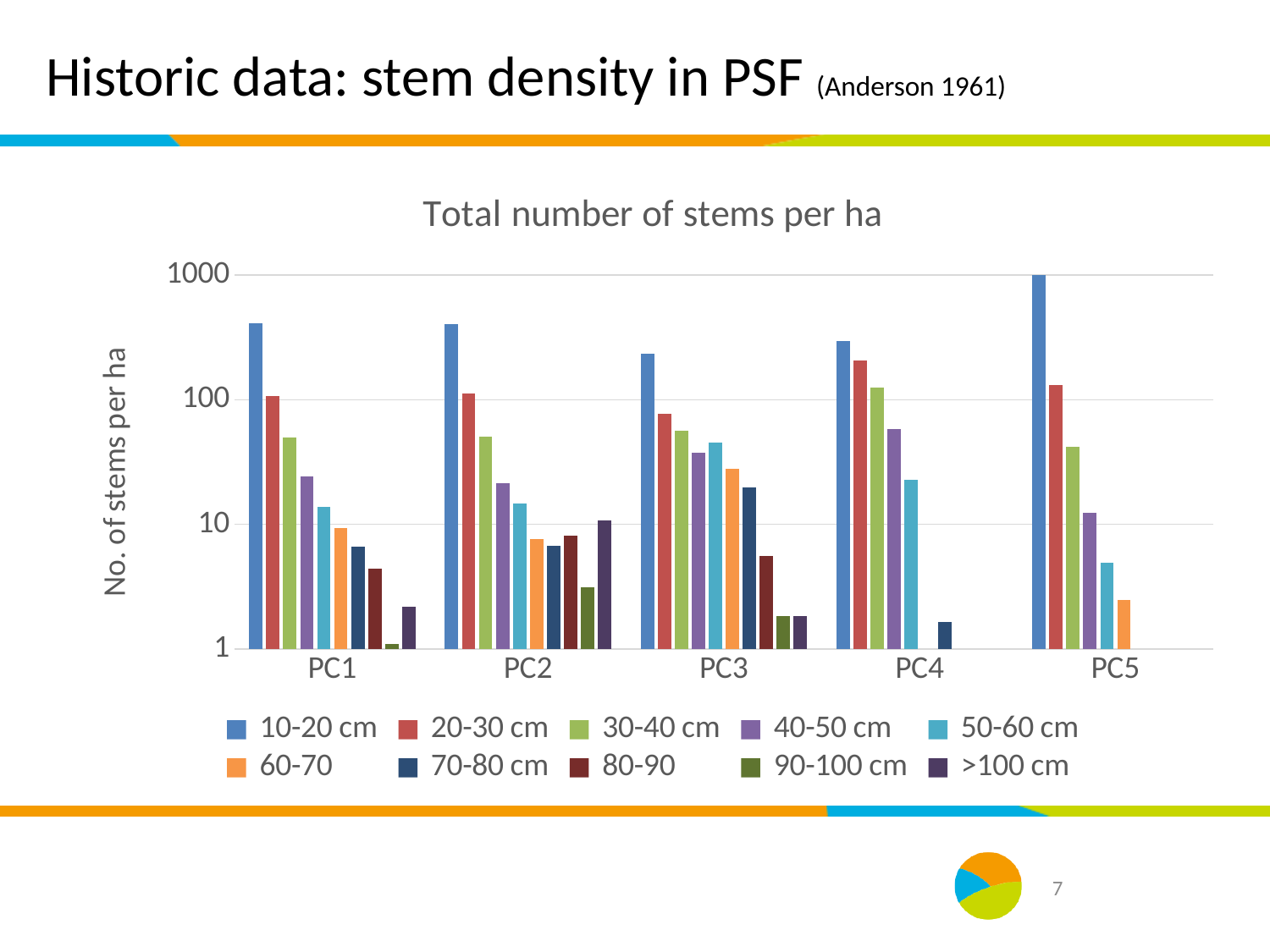
How many categories (PC groups) are shown on the x axis? 5 Within PC1, which series has the highest value? 10-20 cm Within PC5, do the values rise or fall going from the 10-20 cm series to the 60-70 series? fall How many series does the legend list? 10 Which category has the highest value for the 10-20 cm series? PC5 What kind of chart is shown on the slide? bar chart Is the value for 10-20 cm in PC1 greater or less than 100? greater Is the value for >100 cm in PC1 greater or less than 10? less What is the title of the chart? Total number of stems per ha Within PC1, which series has the lowest value? 90-100 cm What is the label of the y axis? No. of stems per ha Which is larger, the 10-20 cm value for PC1 or the 10-20 cm value for PC3? PC1